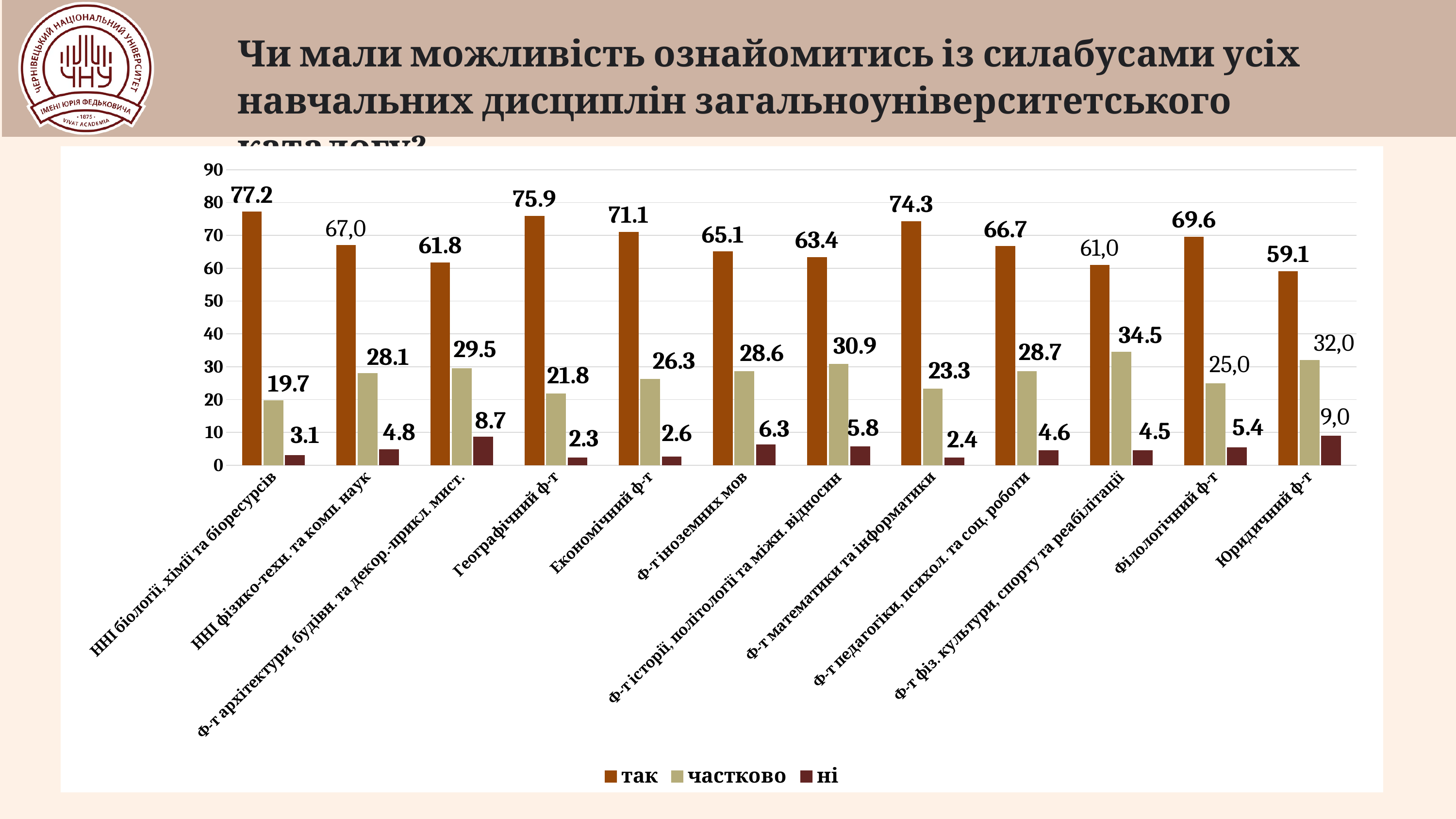
Which category has the lowest value in the "так" series? Юридичний ф-т What kind of chart is shown on the slide? Bar chart What is the value of the "частково" series for Ф-т фіз. культури, спорту та реабілітації? 34.5 Which is larger: the "частково" value for Ф-т історії, політології та міжн. відносин or for Ф-т математики та інформатики? Ф-т історії, політології та міжн. відносин What is the value of the "ні" series for Ф-т архітектури, будівн. та декор.-прикл. мист.? 8.7 Which category has the lowest value in the "ні" series? Географічний ф-т What is the difference between the "так" values for ННІ біології, хімії та біоресурсів and Юридичний ф-т? 18.1 How many categories (faculties) are shown on the x axis? 12 How many series does the legend list? 3 Which category has the highest value in the "так" series? ННІ біології, хімії та біоресурсів Which category has the highest value in the "ні" series? Юридичний ф-т What is the value of the "так" series for Географічний ф-т? 75.9